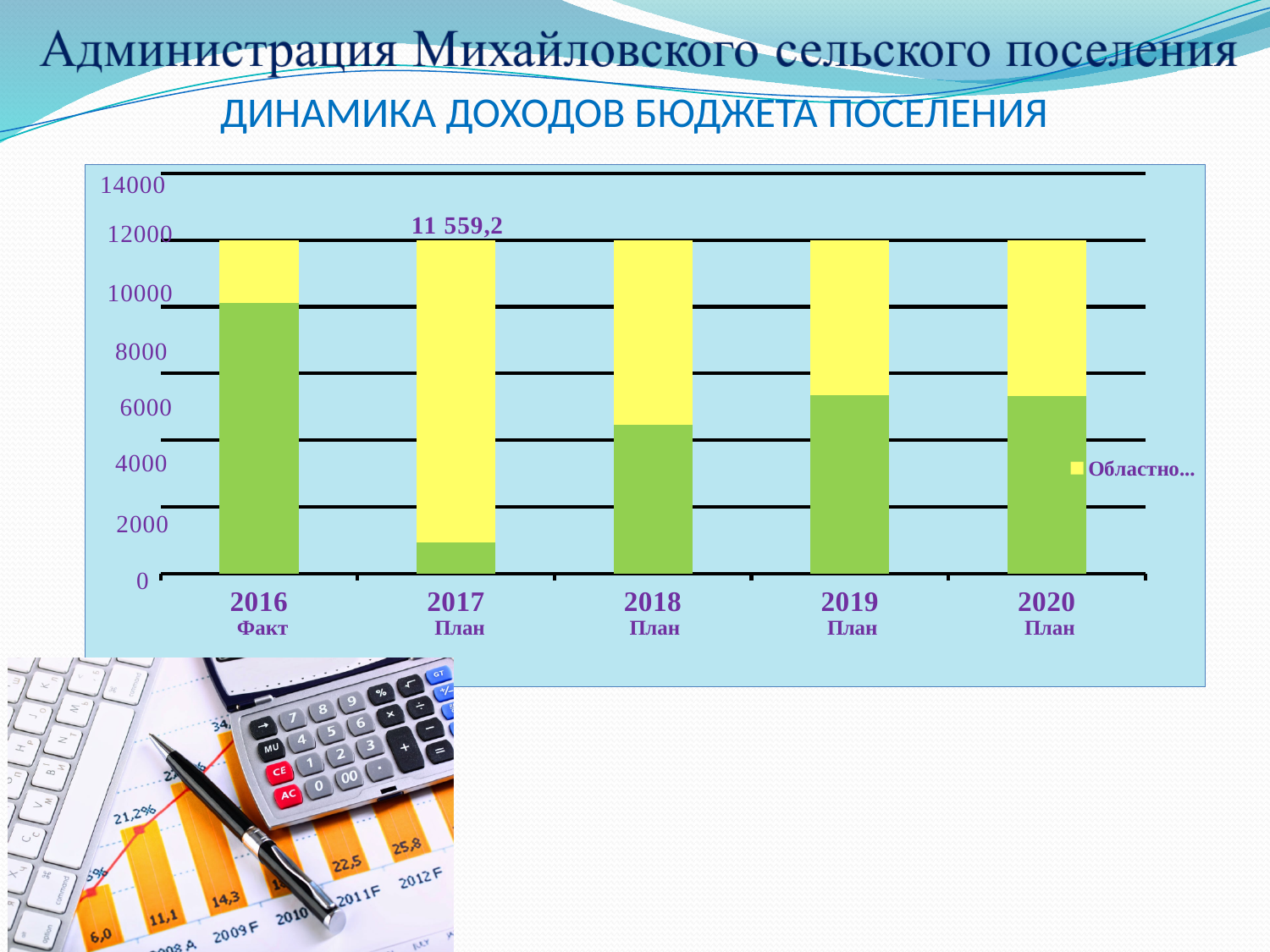
What kind of chart is shown on the slide? bar chart Is the green segment for 2016 greater or less than 8000? greater Is the green segment for 2018 greater or less than 4000? greater Which year has the shortest green segment? 2017 Is the green segment for 2017 greater or less than 2000? less Which year has the largest yellow segment? 2017 Which year on the x axis is labeled Факт rather than План? 2016 Which year has the tallest green segment? 2016 How many years (categories) are shown on the x axis of the chart? 5 What value is printed as the data label above the 2017 План bar? 11 559,2 What is the title of the chart? ДИНАМИКА ДОХОДОВ БЮДЖЕТА ПОСЕЛЕНИЯ Which is larger, the green segment for 2016 or the green segment for 2018? 2016